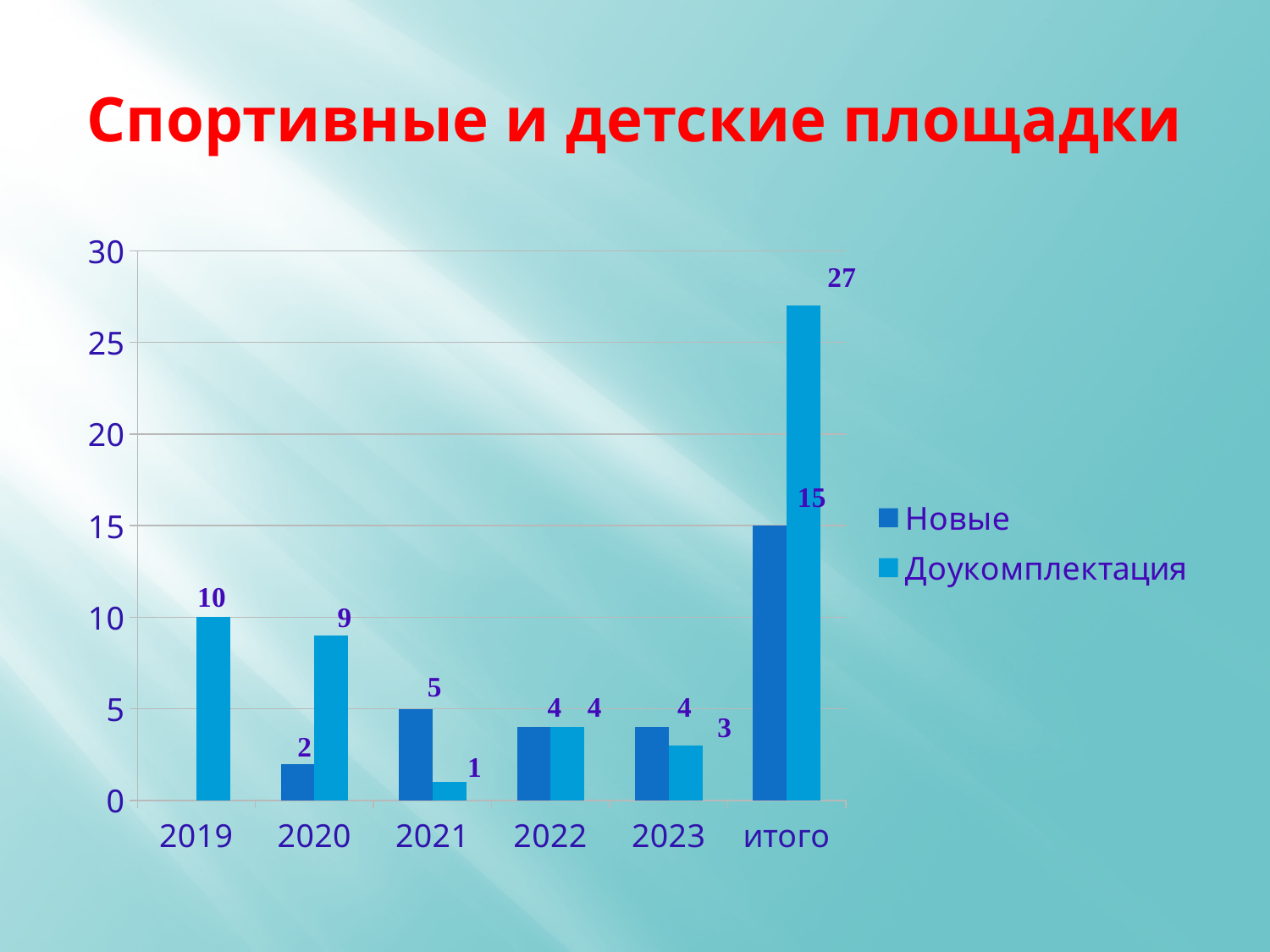
What is the value for Доукомплектация in 2019? 10 What is the value for Новые in the итого category? 15 What is the title of the chart? Спортивные и детские площадки What type of chart is shown on the slide? bar chart How many categories are shown on the x axis? 6 What is the value for Доукомплектация in 2021? 1 What is the value for Новые in 2020? 2 What is the difference between Доукомплектация and Новые in the итого category? 12 Which year has the lowest value for Доукомплектация? 2021 In 2021, which is larger: Новые or Доукомплектация? Новые How many series does the legend list? 2 Which category has the highest value for Доукомплектация? итого